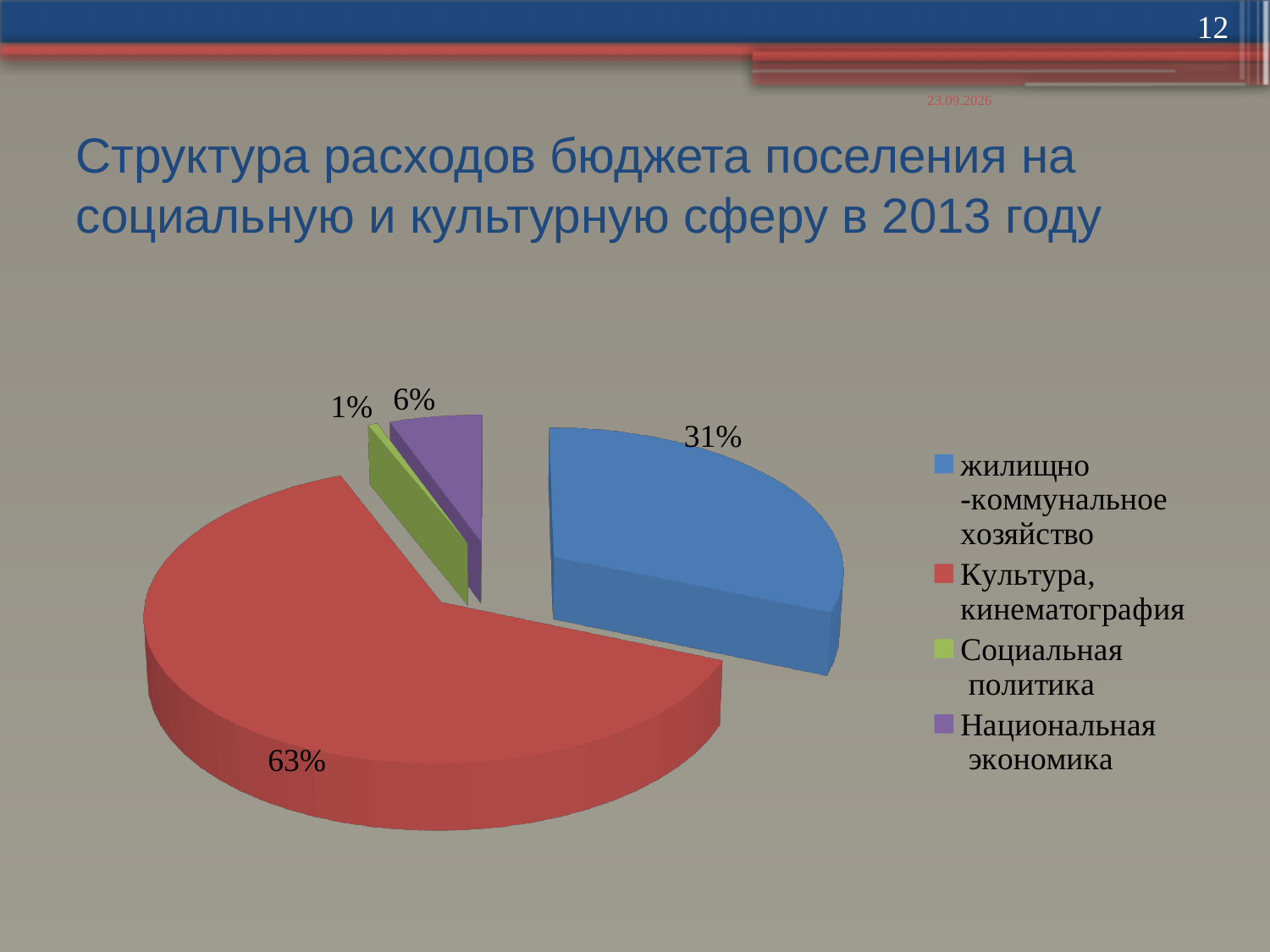
What share of the pie does Социальная политика have? 1% Which is larger: the share for Национальная экономика or the share for Социальная политика? Национальная экономика How many categories does the pie chart show? 4 What share of the pie does Культура, кинематография have? 63% Which category has the largest slice of the pie? Культура, кинематография What share of the pie does жилищно-коммунальное хозяйство have? 31% What is the difference in percentage points between Культура, кинематография and жилищно-коммунальное хозяйство? 32 Which category has the smallest slice of the pie? Социальная политика What kind of chart is shown on the slide? pie chart Which category is shown in blue in the legend? жилищно-коммунальное хозяйство What colour is the slice for Культура, кинематография? red